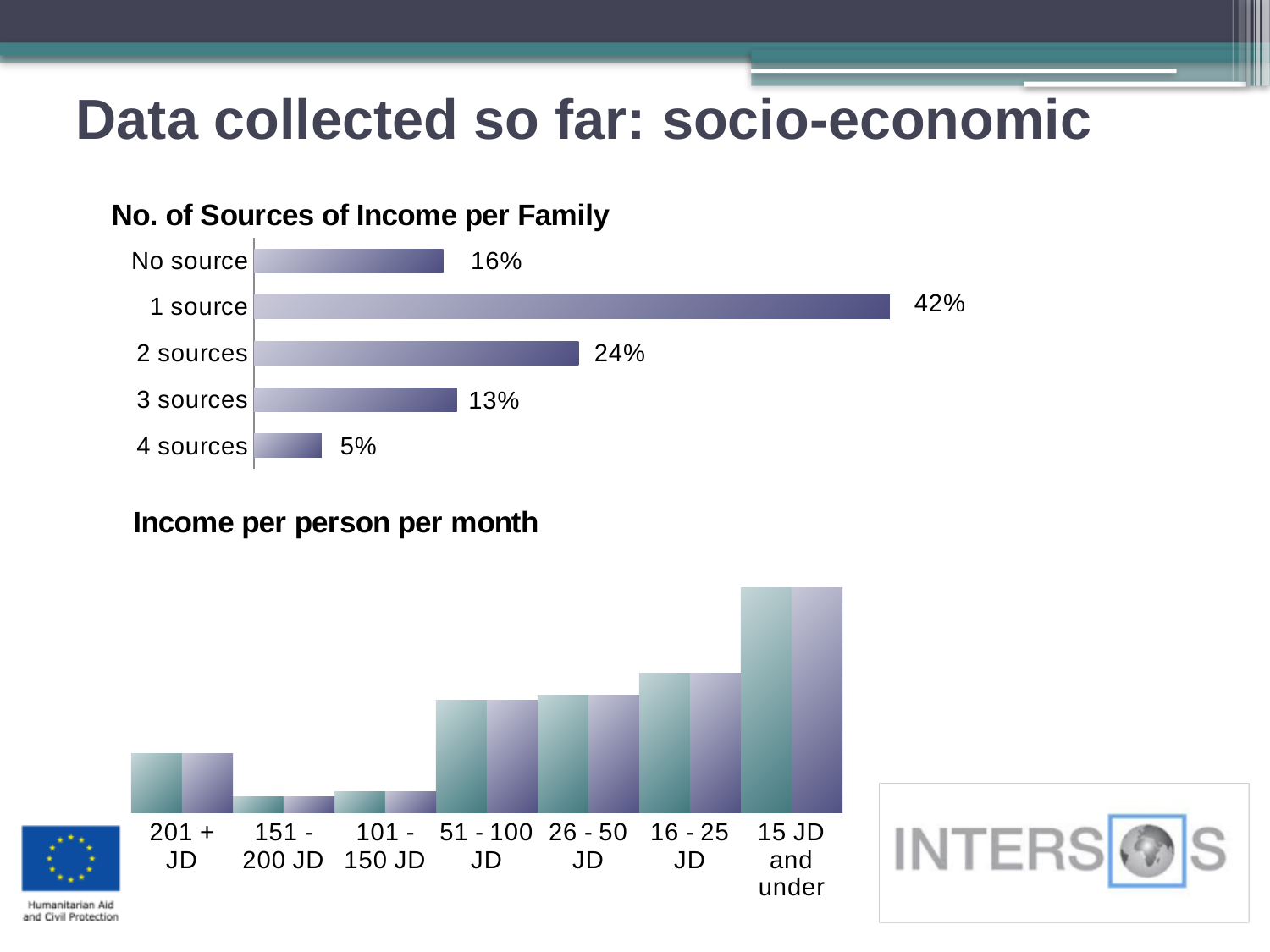
In the 'Income per person per month' chart, which bar is taller: '26 - 50 JD' or '16 - 25 JD'? 16 - 25 JD In the 'No. of Sources of Income per Family' chart, what is the value for 'No source'? 16% How many income brackets are shown in the 'Income per person per month' chart? 7 How many categories are shown in the 'No. of Sources of Income per Family' chart? 5 In the 'No. of Sources of Income per Family' chart, which category has the lowest value? 4 sources In the 'No. of Sources of Income per Family' chart, what percentage of families have 1 source of income? 42% In the 'No. of Sources of Income per Family' chart, what is the difference between the values for 1 source and 2 sources? 18% What type of chart is the 'No. of Sources of Income per Family' chart? Bar chart In the 'Income per person per month' chart, which income bracket has the shortest bar? 151 - 200 JD In the 'Income per person per month' chart, which income bracket has the tallest bar? 15 JD and under In the 'No. of Sources of Income per Family' chart, which is larger: the value for 'No source' or for '3 sources'? No source In the 'No. of Sources of Income per Family' chart, which category has the highest value? 1 source